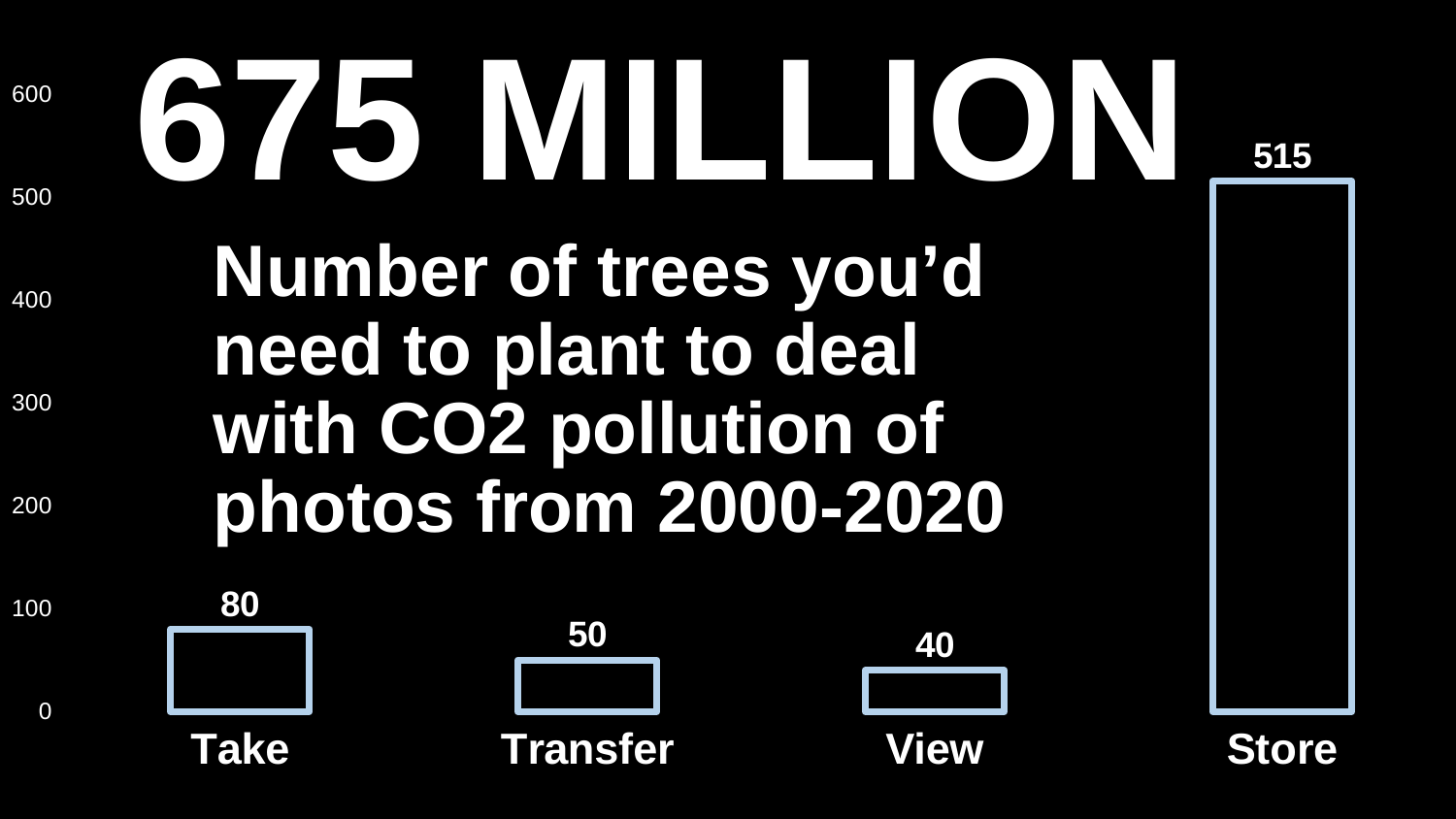
Which category has the highest value? Store What is the value for Transfer? 50 Which is larger, the value for Transfer or the value for View? Transfer How many categories are shown on the x axis? 4 Which category has the lowest value? View What is the value for View? 40 Is the value for Store greater or less than 500? greater What is the difference between the values for Store and Take? 435 What kind of chart is shown on the slide? bar chart What is the difference between the values for Take and View? 40 What is the value for Store? 515 What is the value for Take? 80